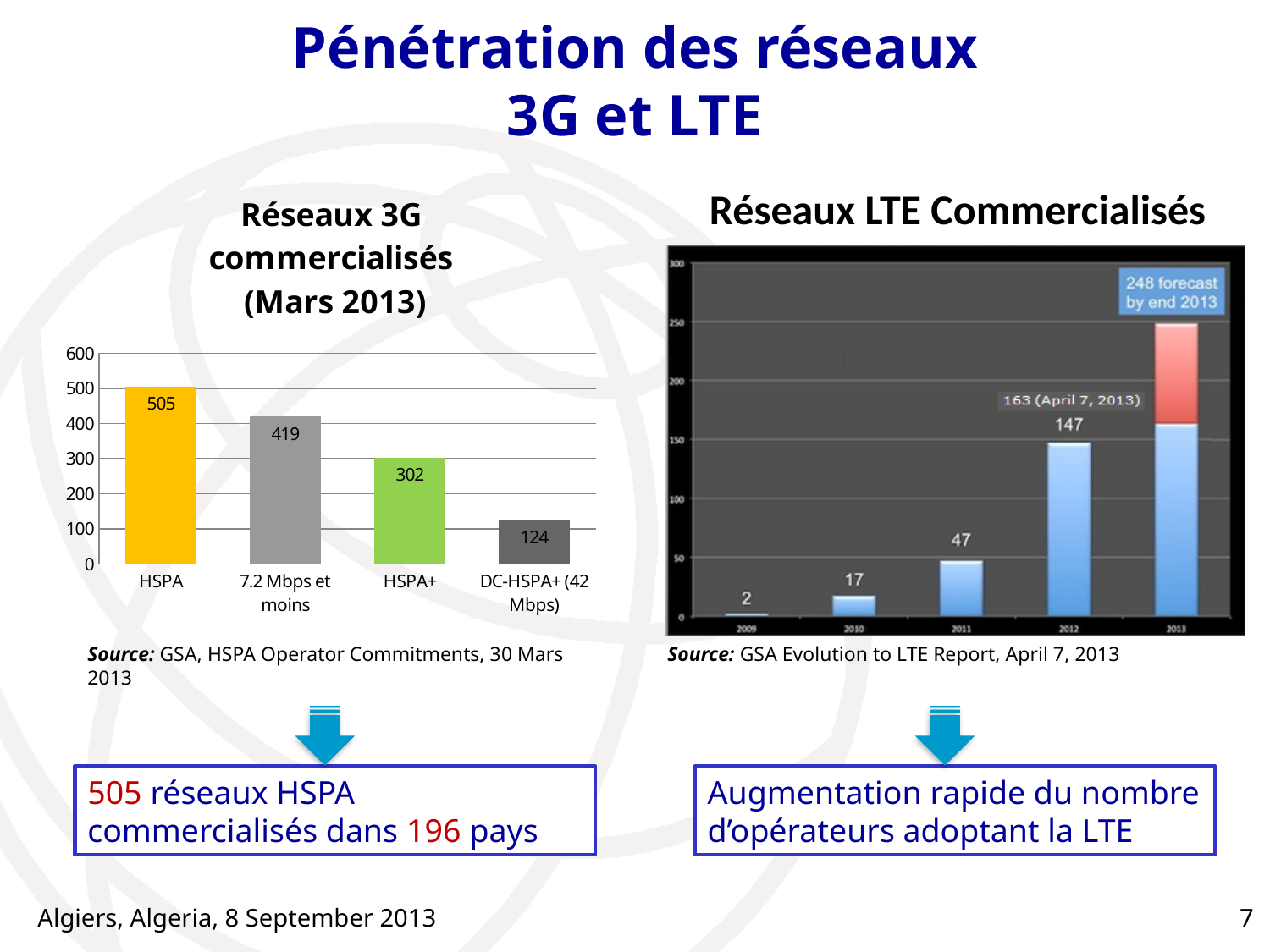
In the 'Réseaux 3G commercialisés (Mars 2013)' chart, what colour is the HSPA bar? Yellow/orange In the 'Réseaux LTE Commercialisés' chart, what is the difference between the 2012 value and the 2010 value? 130 In the 'Réseaux LTE Commercialisés' chart, what is the value for 2011? 47 In the 'Réseaux 3G commercialisés (Mars 2013)' chart, what is the difference between the HSPA value and the HSPA+ value? 203 In the 'Réseaux LTE Commercialisés' chart, do the values rise or fall from 2009 to 2013? Rise In the 'Réseaux 3G commercialisés (Mars 2013)' chart, what is the value for DC-HSPA+ (42 Mbps)? 124 In the 'Réseaux 3G commercialisés (Mars 2013)' chart, how many categories are shown? 4 In the 'Réseaux LTE Commercialisés' chart, what is the forecast value by end 2013? 248 What kind of chart is the 'Réseaux 3G commercialisés (Mars 2013)' chart? Bar chart In the 'Réseaux 3G commercialisés (Mars 2013)' chart, what is the value for HSPA? 505 In the 'Réseaux 3G commercialisés (Mars 2013)' chart, which category has the lowest value? DC-HSPA+ (42 Mbps) In the 'Réseaux LTE Commercialisés' chart, what is the value for 2012? 147